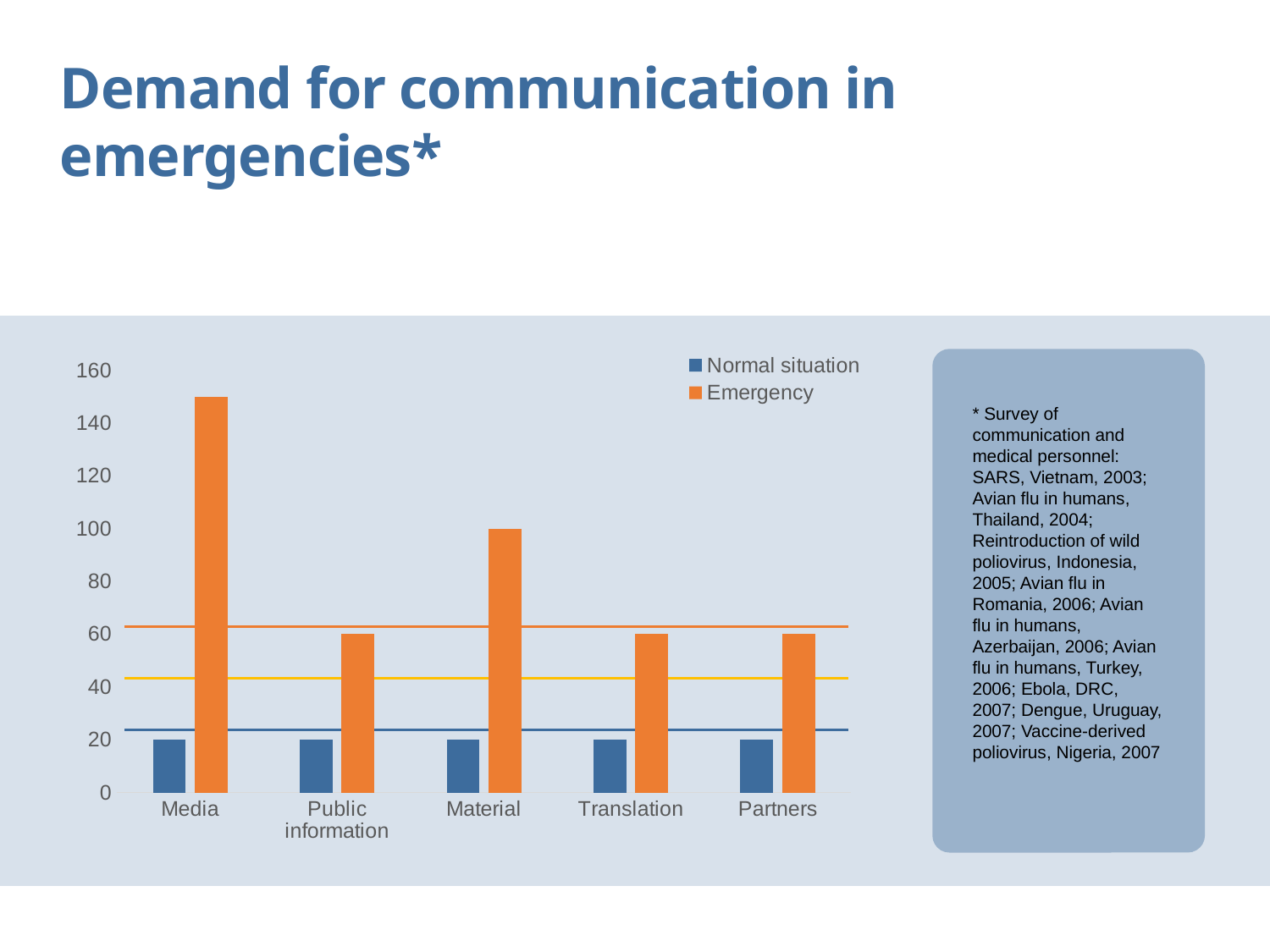
What kind of chart is shown on the slide? Bar chart How many series does the legend list? 2 Is the Emergency value for Media greater or less than 140? greater Is the Emergency value for Material greater or less than 120? less What are the two series named in the legend? Normal situation and Emergency Which category has the highest Emergency value? Media Which is larger, the Emergency value for Media or the Emergency value for Material? Media How many categories are shown on the x axis? 5 What colour are the Emergency bars? Orange Is the Normal situation value for Media greater or less than 40? less For Translation, which series has the larger value, Normal situation or Emergency? Emergency